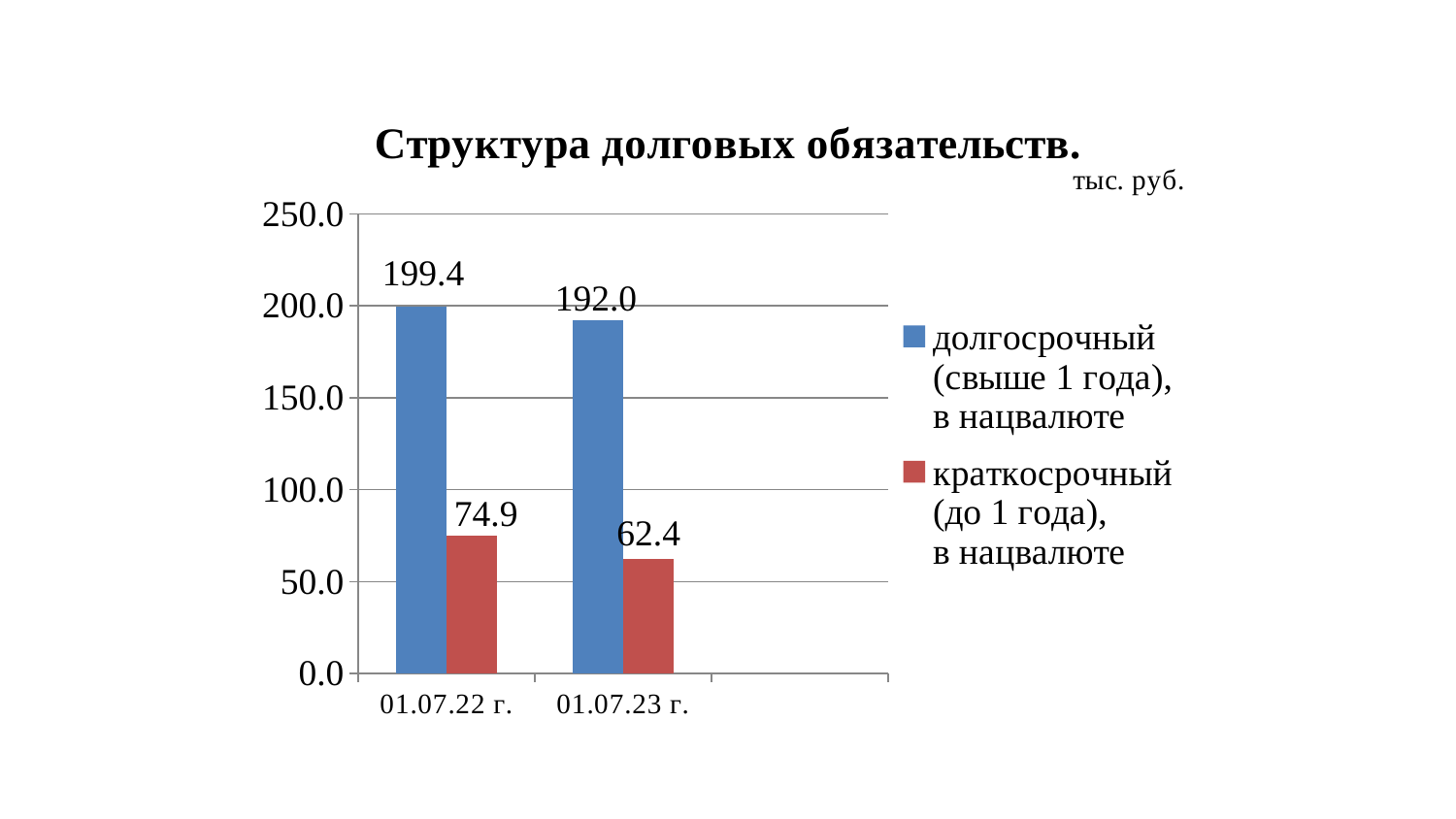
Which date has the higher value for долгосрочный (свыше 1 года), в нацвалюте? 01.07.22 г. Which is larger for 01.07.23 г.: долгосрочный or краткосрочный? долгосрочный What is the title of the chart? Структура долговых обязательств. What is the value of долгосрочный (свыше 1 года), в нацвалюте for 01.07.23 г.? 192.0 What is the difference between the долгосрочный values for 01.07.22 г. and 01.07.23 г.? 7.4 What is the difference between the краткосрочный values for 01.07.22 г. and 01.07.23 г.? 12.5 How many series does the legend list? 2 What is the value of краткосрочный (до 1 года), в нацвалюте for 01.07.23 г.? 62.4 What is the value of долгосрочный (свыше 1 года), в нацвалюте for 01.07.22 г.? 199.4 Which date has the lower value for краткосрочный (до 1 года), в нацвалюте? 01.07.23 г. What is the value of краткосрочный (до 1 года), в нацвалюте for 01.07.22 г.? 74.9 What kind of chart is shown on the slide? bar chart